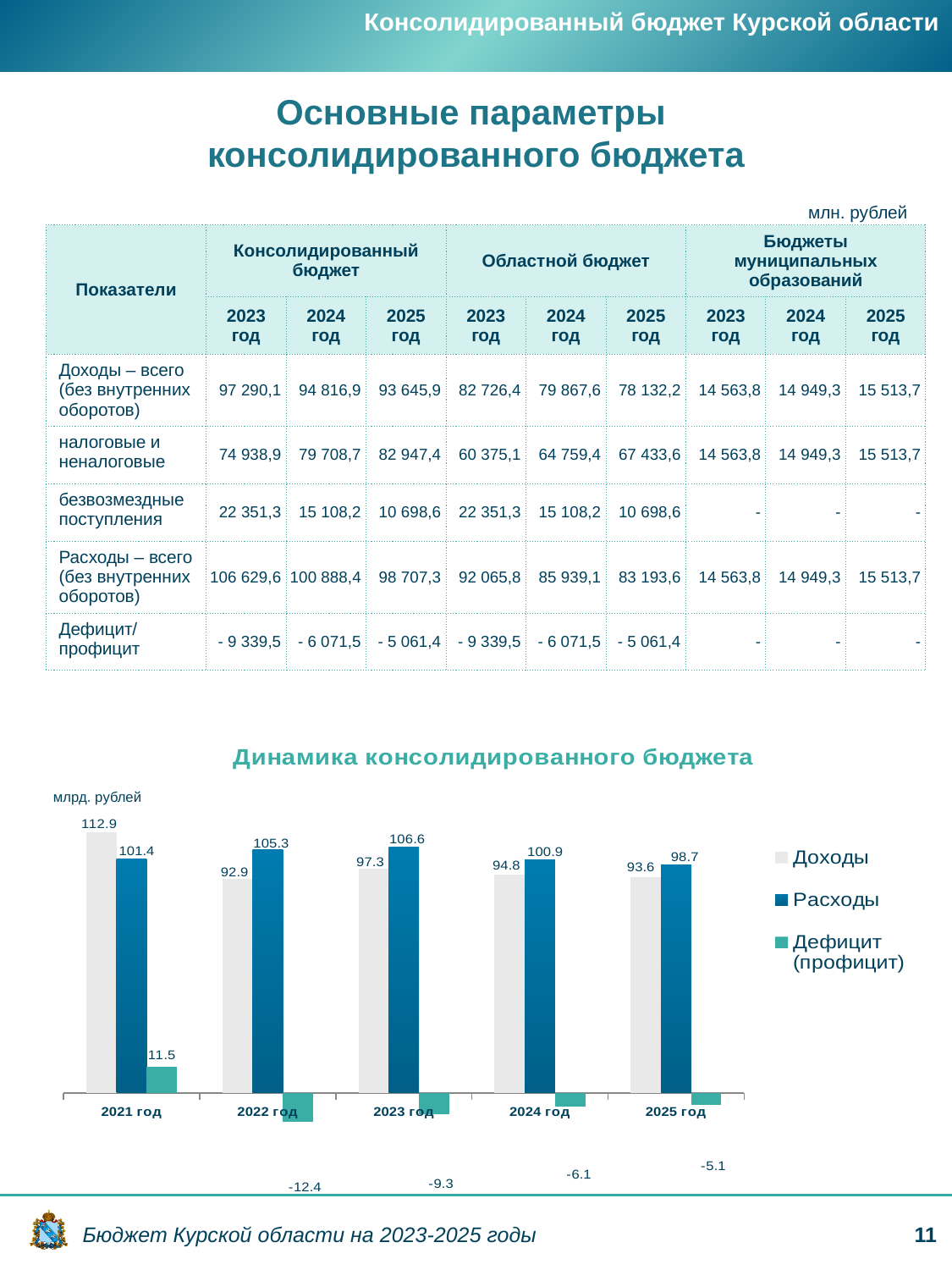
In the chart 'Динамика консолидированного бюджета', which year has the lowest value of Расходы? 2025 год What unit is indicated above the chart 'Динамика консолидированного бюджета'? млрд. рублей In the chart 'Динамика консолидированного бюджета', which year has the highest value of Доходы? 2021 год In the chart 'Динамика консолидированного бюджета', do the Расходы values rise or fall from 2023 год to 2025 год? fall What type of chart is shown under the title 'Динамика консолидированного бюджета'? bar chart In the chart 'Динамика консолидированного бюджета', which is larger for 2022 год: Доходы or Расходы? Расходы In the chart 'Динамика консолидированного бюджета', what is the value of Доходы for 2021 год? 112.9 In the chart 'Динамика консолидированного бюджета', what is the value of Расходы for 2023 год? 106.6 How many years are shown on the x axis of the chart 'Динамика консолидированного бюджета'? 5 In the chart 'Динамика консолидированного бюджета', what is the difference between Расходы and Доходы for 2024 год? 6.1 How many series does the legend of the chart 'Динамика консолидированного бюджета' list? 3 In the chart 'Динамика консолидированного бюджета', what is the value of Дефицит (профицит) for 2022 год? -12.4